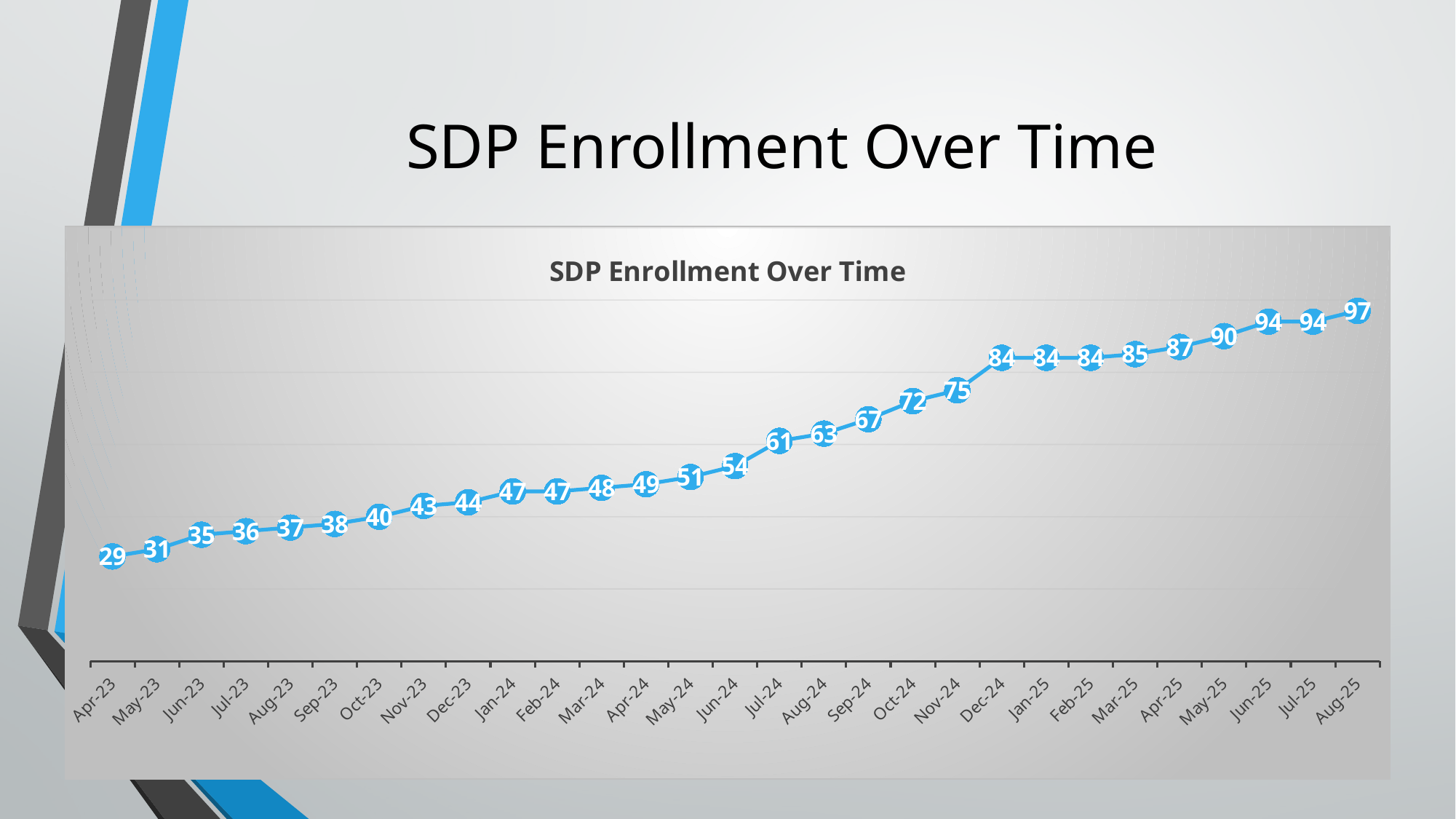
What is the difference in enrollment between Dec-24 and Nov-24? 9 What is the SDP enrollment value for Aug-25? 97 What is the SDP enrollment value for Jul-24? 61 What kind of chart is shown on the slide? Line chart Which month has the lowest SDP enrollment? Apr-23 What is the SDP enrollment value for Apr-23? 29 Which is larger, the enrollment for Oct-24 or for Jun-24? Oct-24 What is the SDP enrollment value for Dec-24? 84 How many data points are plotted on the chart? 29 What is the difference in enrollment between Aug-25 and Apr-23? 68 Do the enrollment values generally rise or fall from Apr-23 to Aug-25? Rise Which month has the highest SDP enrollment? Aug-25